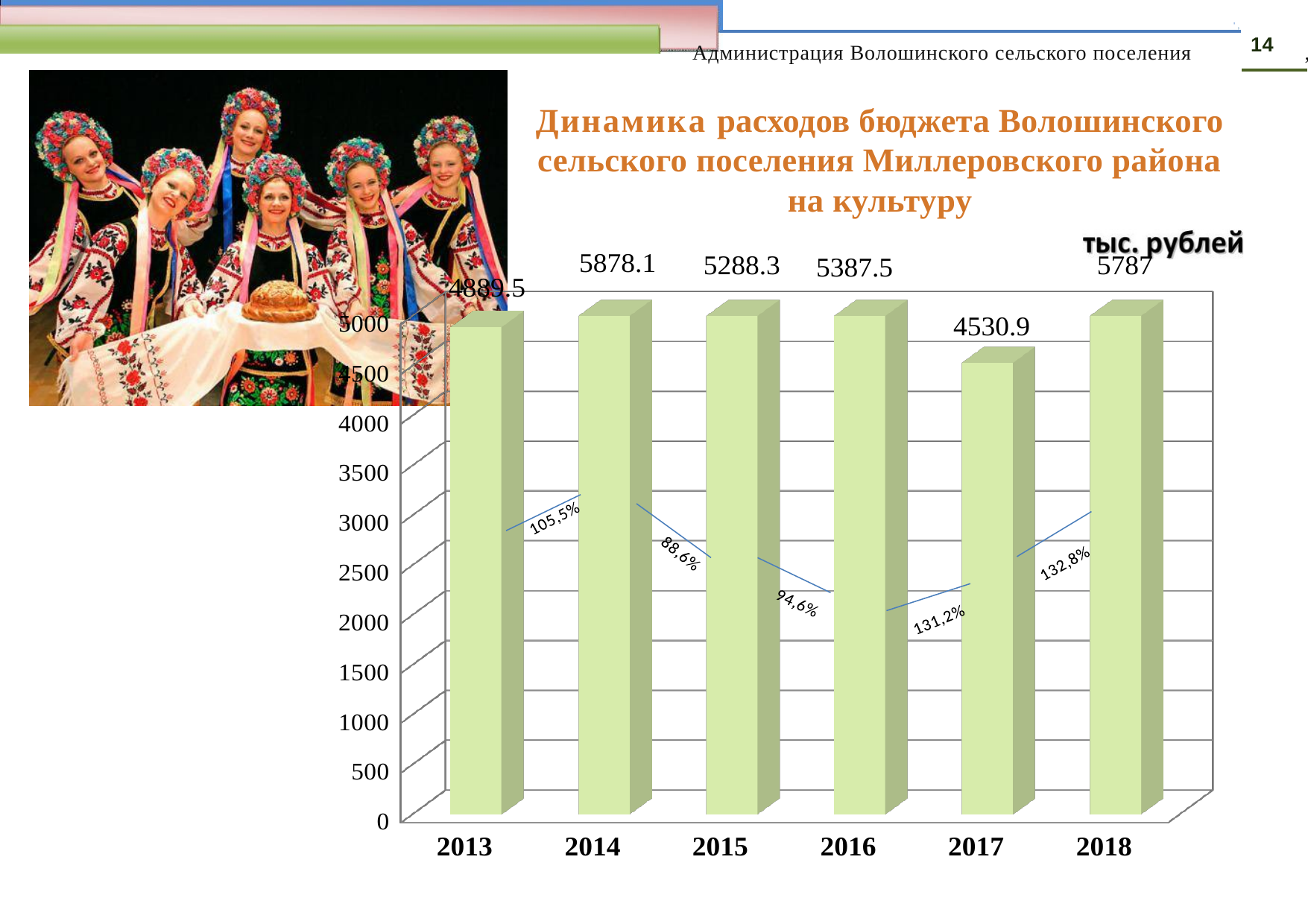
Which year has the highest value? 2014 Which is larger, the value for 2015 or the value for 2016? 2016 What is the value for 2018? 5787 What is the difference between the values for 2014 and 2018? 91.1 Is the value for 2017 greater or less than 5000? less What is the difference between the values for 2016 and 2015? 99.2 Which year has the lowest value? 2017 How many years are shown on the x axis? 6 What is the value for 2014? 5878.1 What is the value for 2017? 4530.9 What is the value for 2016? 5387.5 What kind of chart is shown on the slide? bar chart